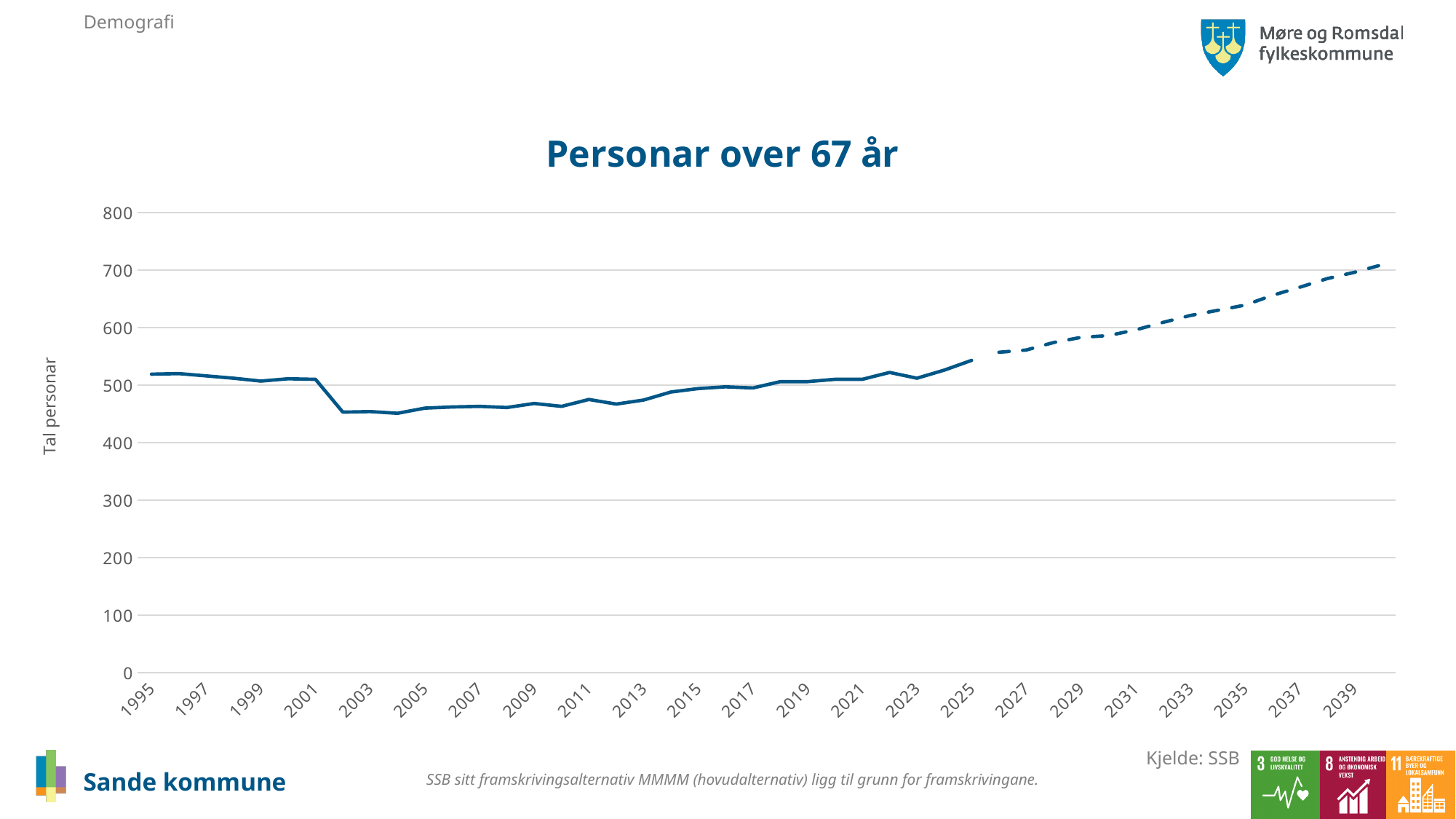
Which is larger, the value for 1995 or the value for 2003? 1995 Do the values rise or fall along the dashed part of the line from 2025 to 2040? rise Is the value at the end of the line (around 2040) greater or less than 600? greater Is the value for 2009 greater or less than 500? less Is the value for 2025 greater or less than 500? greater Which year has the highest value on the chart? 2040 What kind of chart is shown on the slide? line chart What is the label on the vertical axis of the chart? Tal personar What is the title of the chart? Personar over 67 år